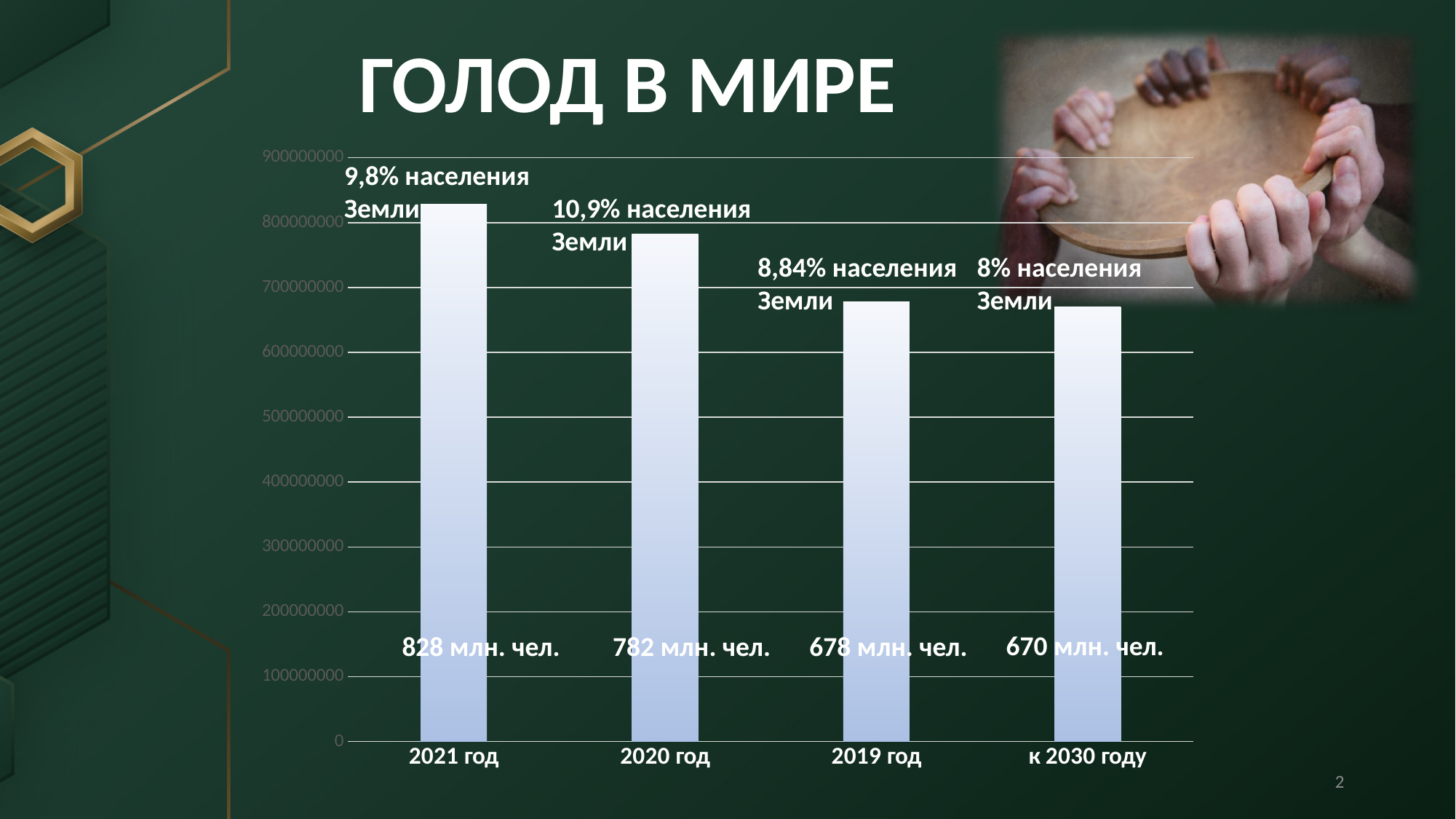
What is the title of the slide? ГОЛОД В МИРЕ What value is shown for 2020 год? 782 млн. чел. Is the value for 2019 год greater or less than 700000000? less What share of the Earth's population is given for 2019 год? 8,84% населения Земли What value is shown for к 2030 году? 670 млн. чел. Which category has the highest value? 2021 год What is the difference between the values for 2021 год and 2020 год? 46 млн. чел. Which is larger, the value for 2019 год or the value for к 2030 году? 2019 год How many categories are shown on the x axis? 4 Which category has the lowest value? к 2030 году What value is shown for 2021 год? 828 млн. чел. What kind of chart is shown on the slide? bar chart